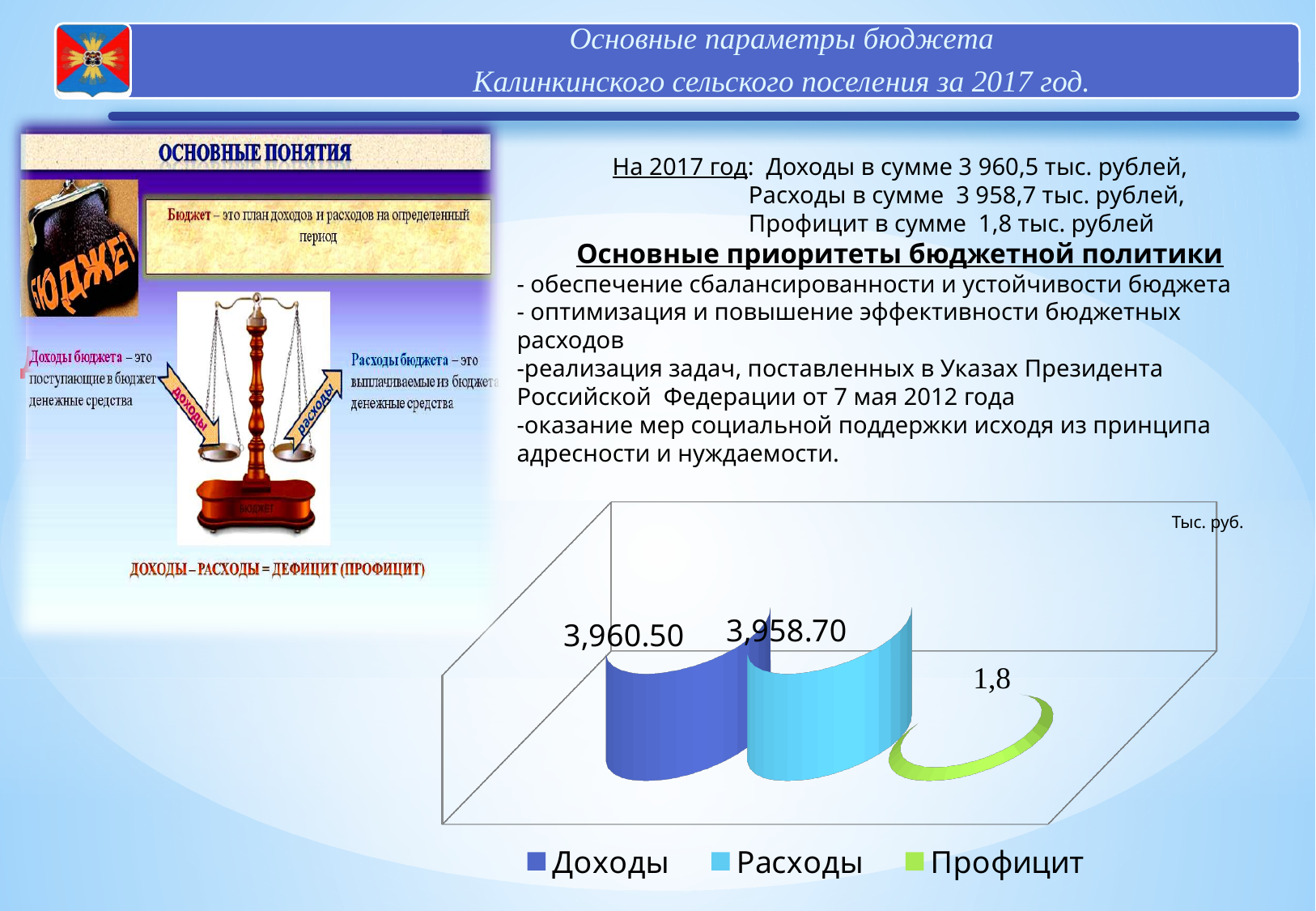
What is the value shown for Профицит on the chart? 1,8 What is the value shown for Расходы on the chart? 3,958.70 Which is larger on the chart, Доходы or Расходы? Доходы What is the value shown for Доходы on the chart? 3,960.50 Which series has the lowest value on the chart? Профицит How many series does the chart legend list? 3 What unit is indicated in the top right corner of the chart? Тыс. руб. What kind of chart is shown on the slide? Bar chart Which series has the highest value on the chart? Доходы How many bars are plotted on the chart? 3 Which is larger on the chart, Расходы or Профицит? Расходы What is the difference between the Доходы and Расходы values on the chart? 1.80